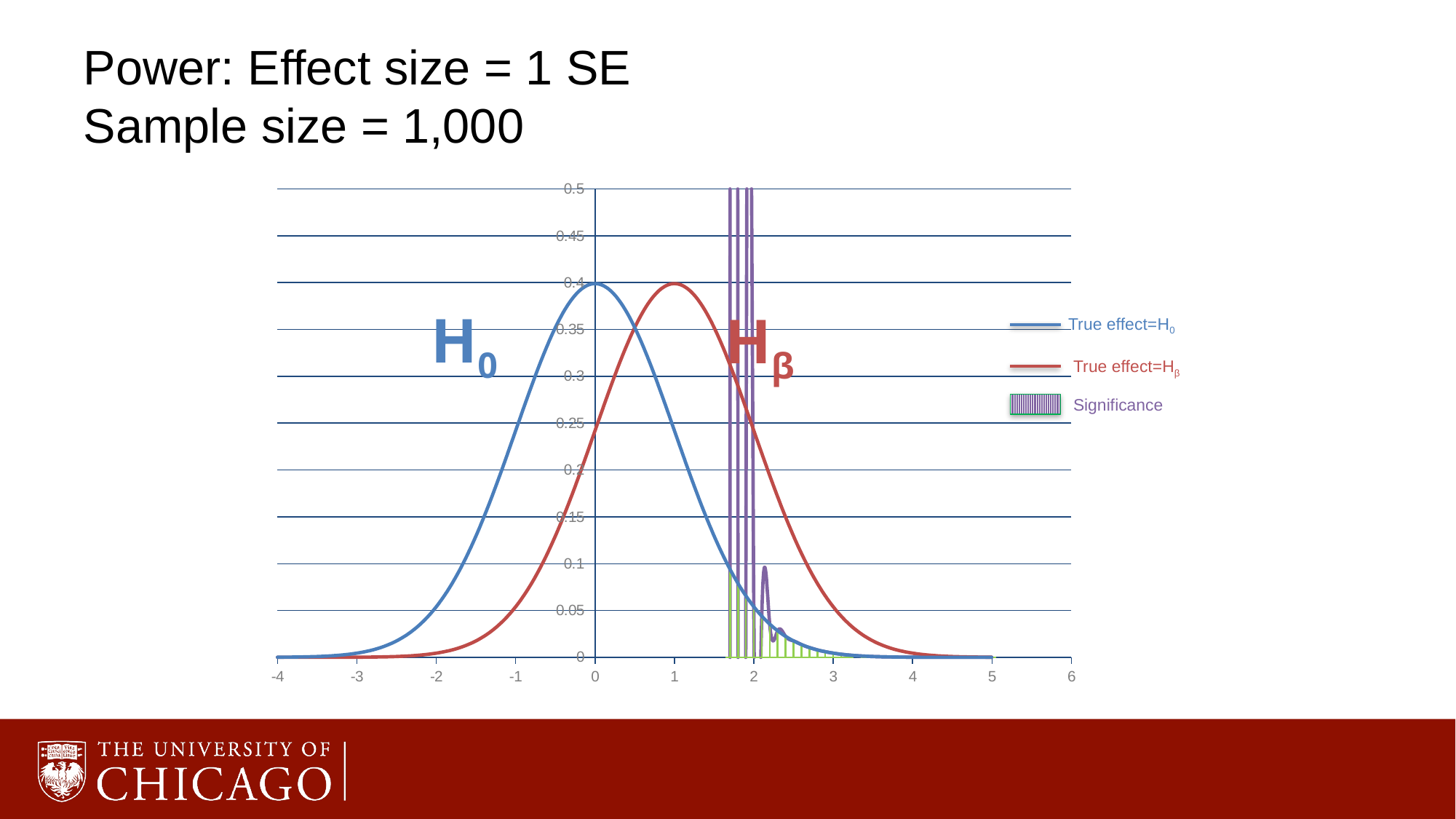
At which x value does the True effect=Hβ curve reach its peak? 1 Is the value of the True effect=H0 curve at x = 1 greater or less than 0.3? less What colour is the True effect=Hβ curve? red At x = -1, which curve has the larger value, True effect=H0 or True effect=Hβ? True effect=H0 What kind of chart is shown on the slide? line chart At which x value does the True effect=H0 curve reach its peak? 0 At x = 2, which curve has the larger value, True effect=H0 or True effect=Hβ? True effect=Hβ Does the True effect=H0 curve rise or fall as x goes from 0 to 3? fall What are the three entries in the chart's legend? True effect=H0, True effect=Hβ, Significance Is the peak value of the True effect=H0 curve greater or less than 0.35? greater Is the peak value of the True effect=Hβ curve greater or less than 0.45? less How many series does the chart's legend list? 3